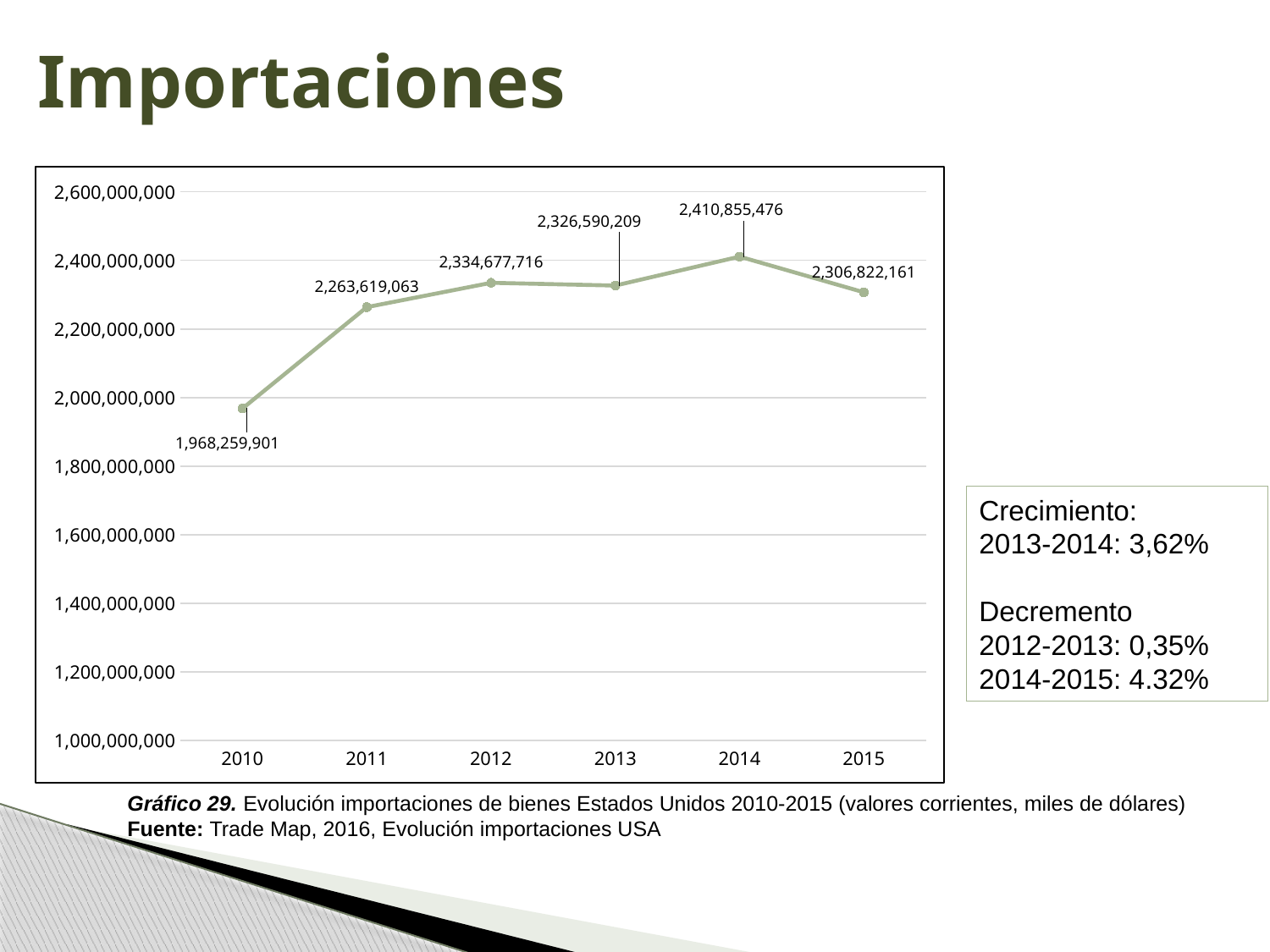
What is the value for 2014? 2,410,855,476 Which year has the highest value? 2014 What is the value for 2015? 2,306,822,161 Which year has the lowest value? 2010 What is the difference between the values for 2011 and 2010? 295,359,162 What is the difference between the values for 2014 and 2013? 84,265,267 Which is larger, the value for 2010 or the value for 2014? 2014 What is the value for 2010? 1,968,259,901 What is the value for 2012? 2,334,677,716 Is the value for 2010 greater or less than 2,000,000,000? less How many years are plotted on the chart? 6 What kind of chart is shown on the slide? line chart